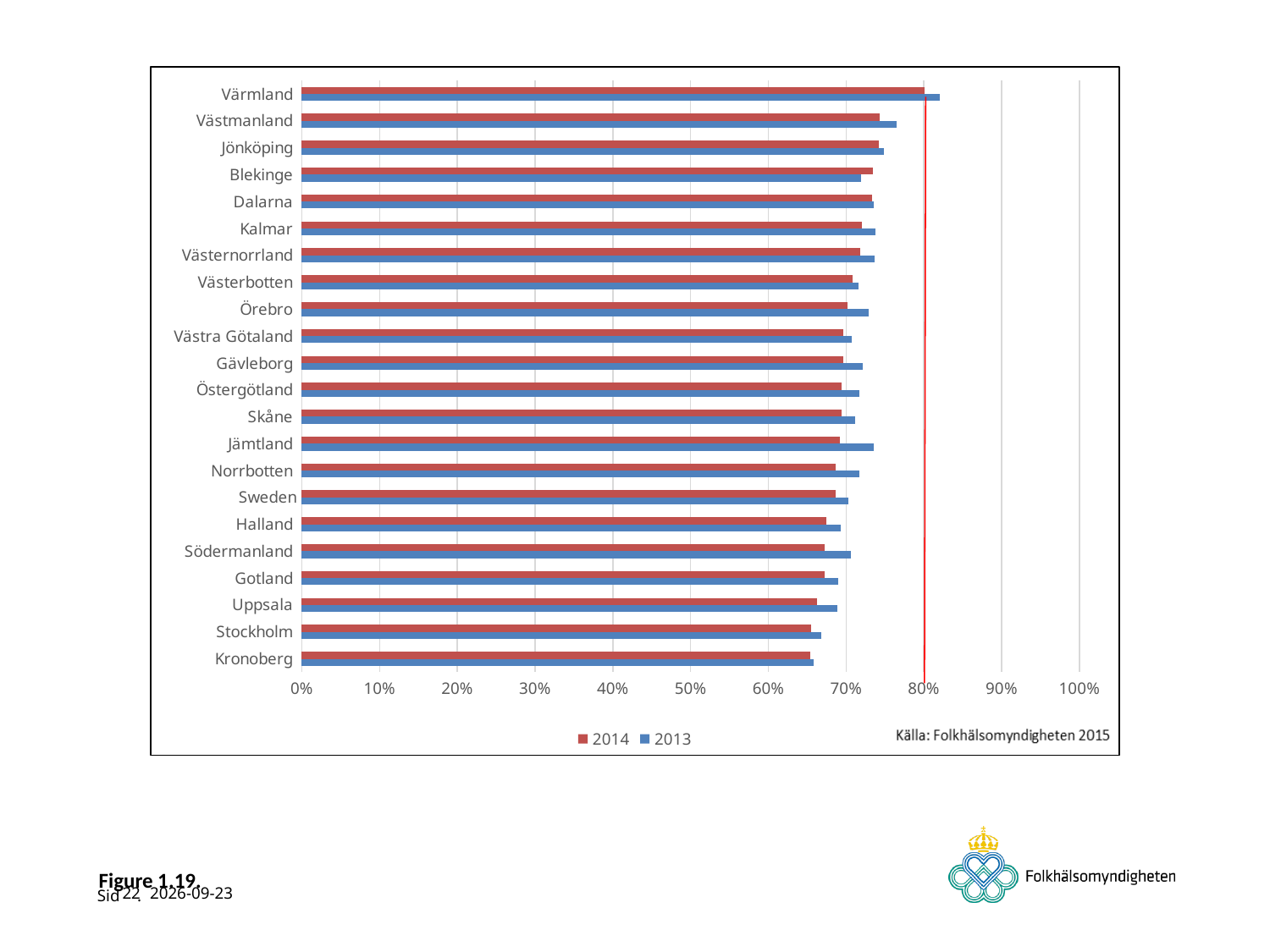
How many series does the legend list? 2 Is the 2014 value for Kronoberg greater or less than 70%? less Which series is shown in red in the legend? 2014 What source is cited at the bottom right of the chart? Källa: Folkhälsomyndigheten 2015 How many regions (categories) are listed on the vertical axis? 22 Is the 2013 value for Stockholm greater or less than 70%? less Which region has the highest value for 2014? Värmland What kind of chart is shown on the slide? bar chart Is the 2014 value for Västmanland greater or less than 70%? greater Which region has the highest value for 2013? Värmland For Jämtland, which year has the larger value, 2013 or 2014? 2013